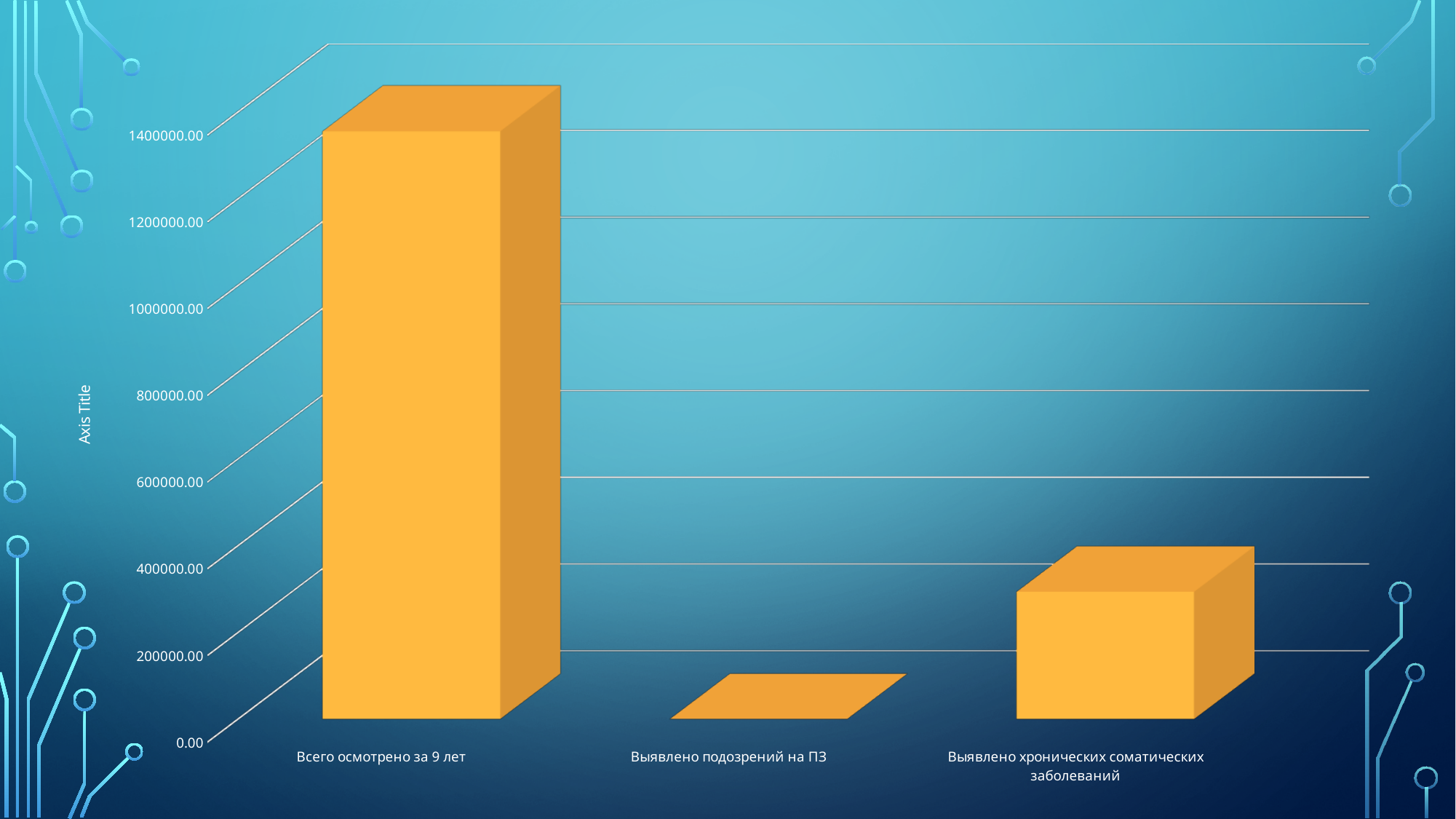
Is the value for "Всего осмотрено за 9 лет" greater or less than 1200000.00? greater What colour are the bars in the chart? orange What is the title shown on the vertical axis of the chart? Axis Title Which is larger: the value for "Всего осмотрено за 9 лет" or the value for "Выявлено хронических соматических заболеваний"? Всего осмотрено за 9 лет Is the value for "Выявлено подозрений на ПЗ" greater or less than 200000.00? less Which category has the lowest value? Выявлено подозрений на ПЗ What kind of chart is shown on the slide? bar chart Is the value for "Выявлено хронических соматических заболеваний" greater or less than 200000.00? greater Which category has the highest value? Всего осмотрено за 9 лет Which is larger: the value for "Выявлено хронических соматических заболеваний" or the value for "Выявлено подозрений на ПЗ"? Выявлено хронических соматических заболеваний How many categories are plotted on the chart? 3